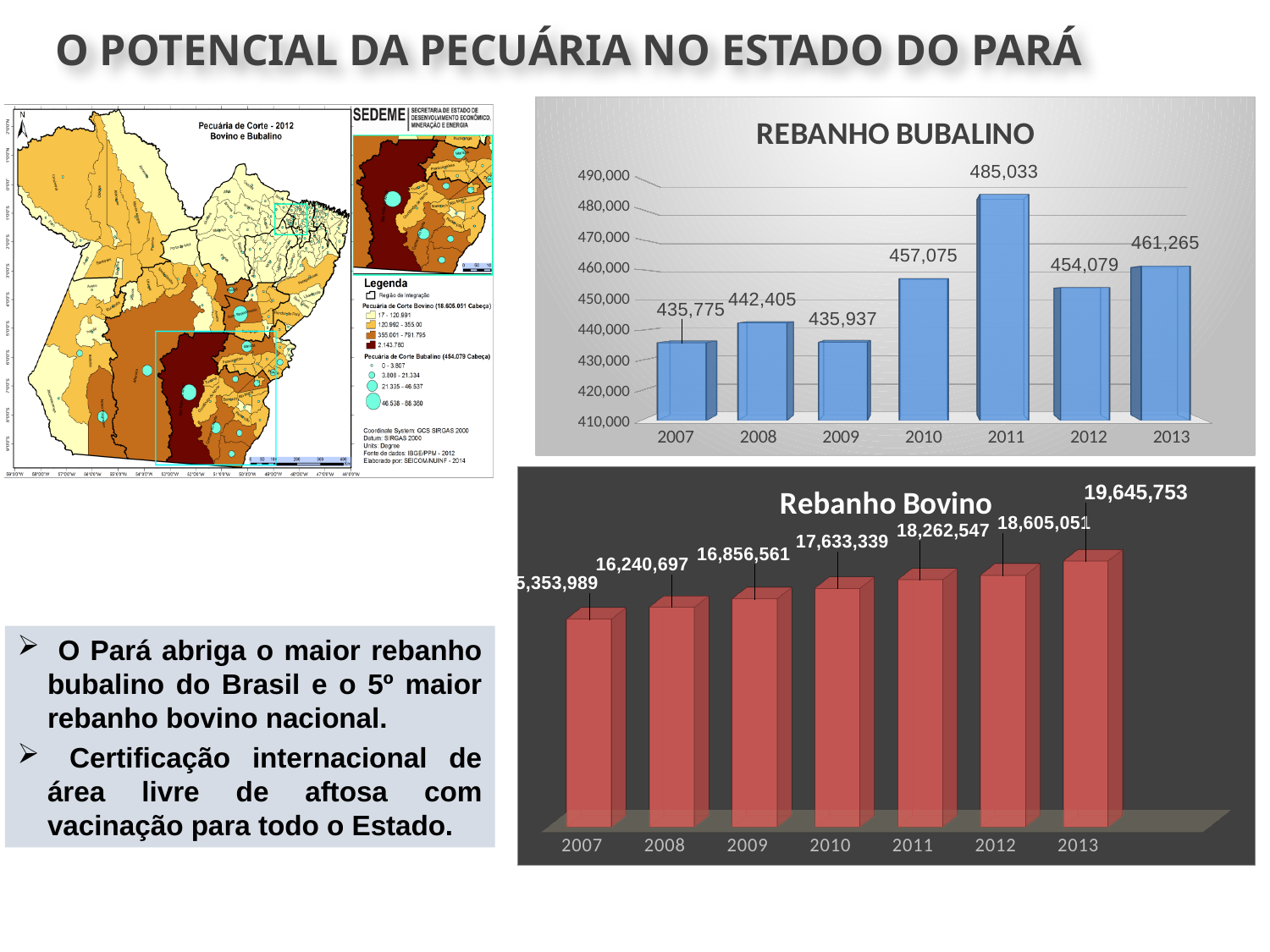
In the Rebanho Bovino chart, do the values rise or fall from 2007 to 2013? rise In the Rebanho Bovino chart, what is the difference between the 2013 value and the 2012 value? 1,040,702 In the REBANHO BUBALINO chart, what is the difference between the 2011 value and the 2012 value? 30,954 What kind of chart is the Rebanho Bovino chart? bar chart In the REBANHO BUBALINO chart, which year has the lowest value? 2007 In the Rebanho Bovino chart, what is the value for 2010? 17,633,339 In the REBANHO BUBALINO chart, which year has the highest value? 2011 In the REBANHO BUBALINO chart, is the value for 2010 greater or less than 450,000? greater In the Rebanho Bovino chart, what is the value for 2013? 19,645,753 In the REBANHO BUBALINO chart, what is the value for 2011? 485,033 In the REBANHO BUBALINO chart, how many years are shown on the x axis? 7 In the REBANHO BUBALINO chart, what is the value for 2013? 461,265